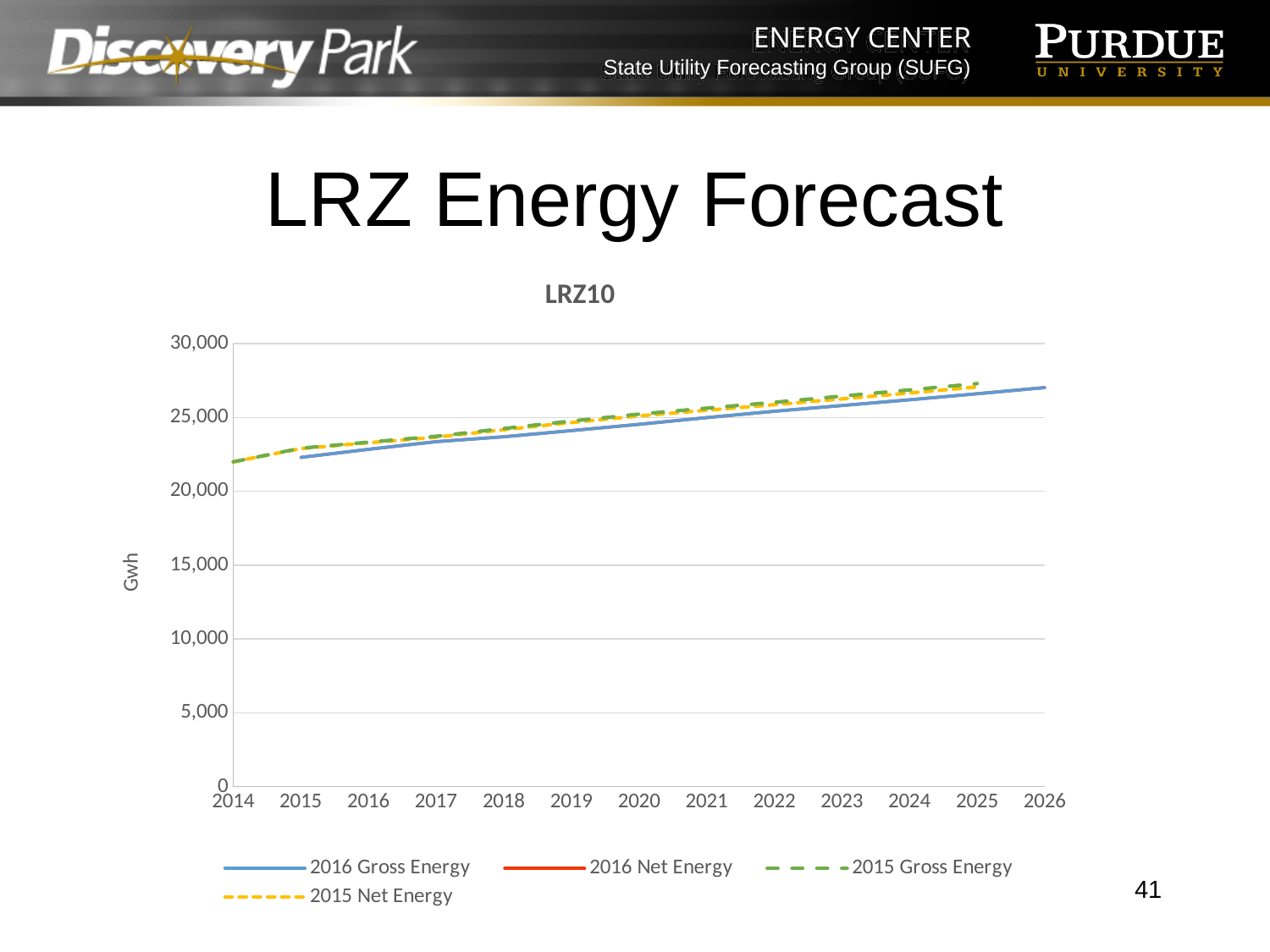
What is the label on the y axis of the chart? Gwh How many years are marked along the x axis of the chart? 13 Do the values for 2015 Gross Energy rise or fall from 2014 to 2025? rise Is the value for 2016 Gross Energy in 2026 greater or less than 25,000? greater What kind of chart is shown on the slide? line chart What is the title of the chart? LRZ10 Is the value for 2015 Gross Energy in 2014 greater or less than 25,000? less Is the value for 2015 Net Energy in 2025 greater or less than 25,000? greater How many series does the chart legend list? 4 Do the values for 2016 Gross Energy rise or fall from 2015 to 2026? rise